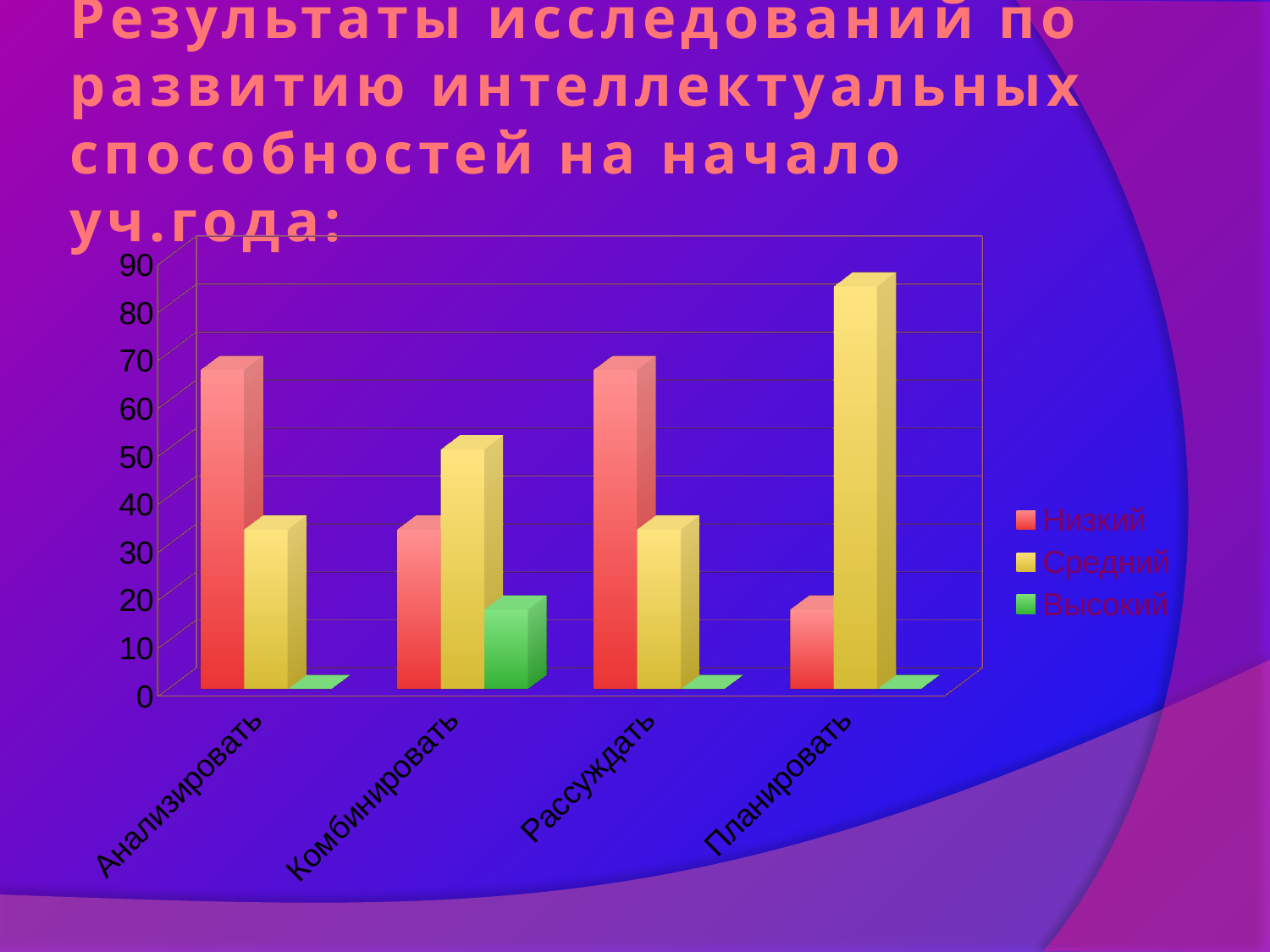
Is the Низкий value for Анализировать greater or less than 60? greater Is the Высокий value for Комбинировать greater or less than 30? less How many categories are shown on the x axis of the chart? 4 How many series does the chart's legend list? 3 For Рассуждать, which is larger: the Низкий value or the Средний value? Низкий Which category has the highest value for the Средний series? Планировать Which series are listed in the chart's legend? Низкий, Средний, Высокий Which category has the lowest value for the Низкий series? Планировать Is the Средний value for Планировать greater or less than 70? greater What kind of chart is shown on the slide? bar chart For Комбинировать, which is larger: the Низкий value or the Средний value? Средний Which category has the highest value for the Высокий series? Комбинировать